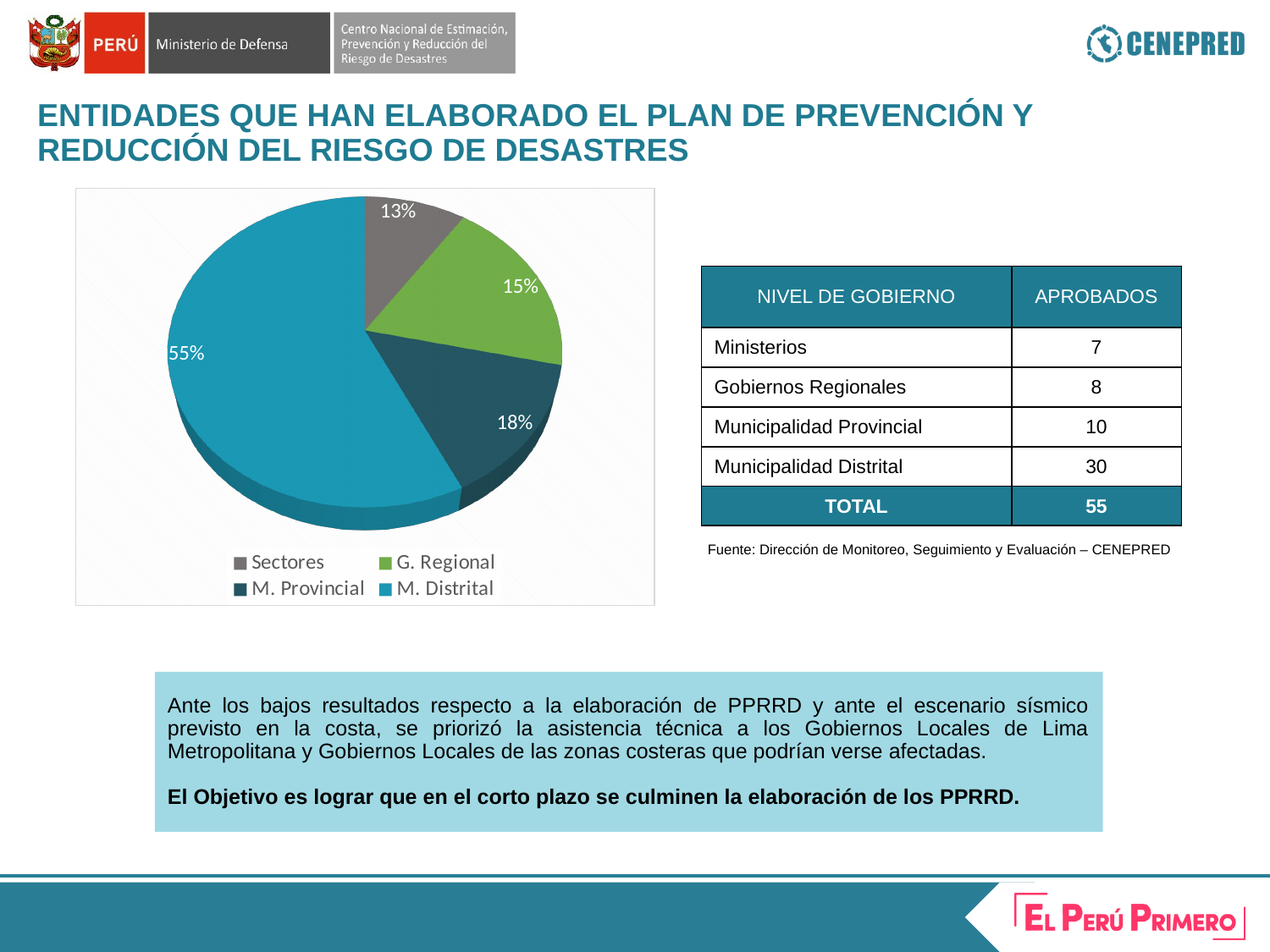
Which legend entry is shown in gray? Sectores What share of the pie does M. Distrital represent? 55% What kind of chart is shown on the slide? Pie chart Which slice is larger, G. Regional or M. Provincial? M. Provincial What share of the pie does G. Regional represent? 15% Which category has the largest slice of the pie? M. Distrital What share of the pie does M. Provincial represent? 18% What is the difference in percentage points between the M. Distrital slice and the M. Provincial slice? 37 Which legend entry is shown in green? G. Regional How many categories does the pie chart show? 4 Which category has the smallest slice of the pie? Sectores